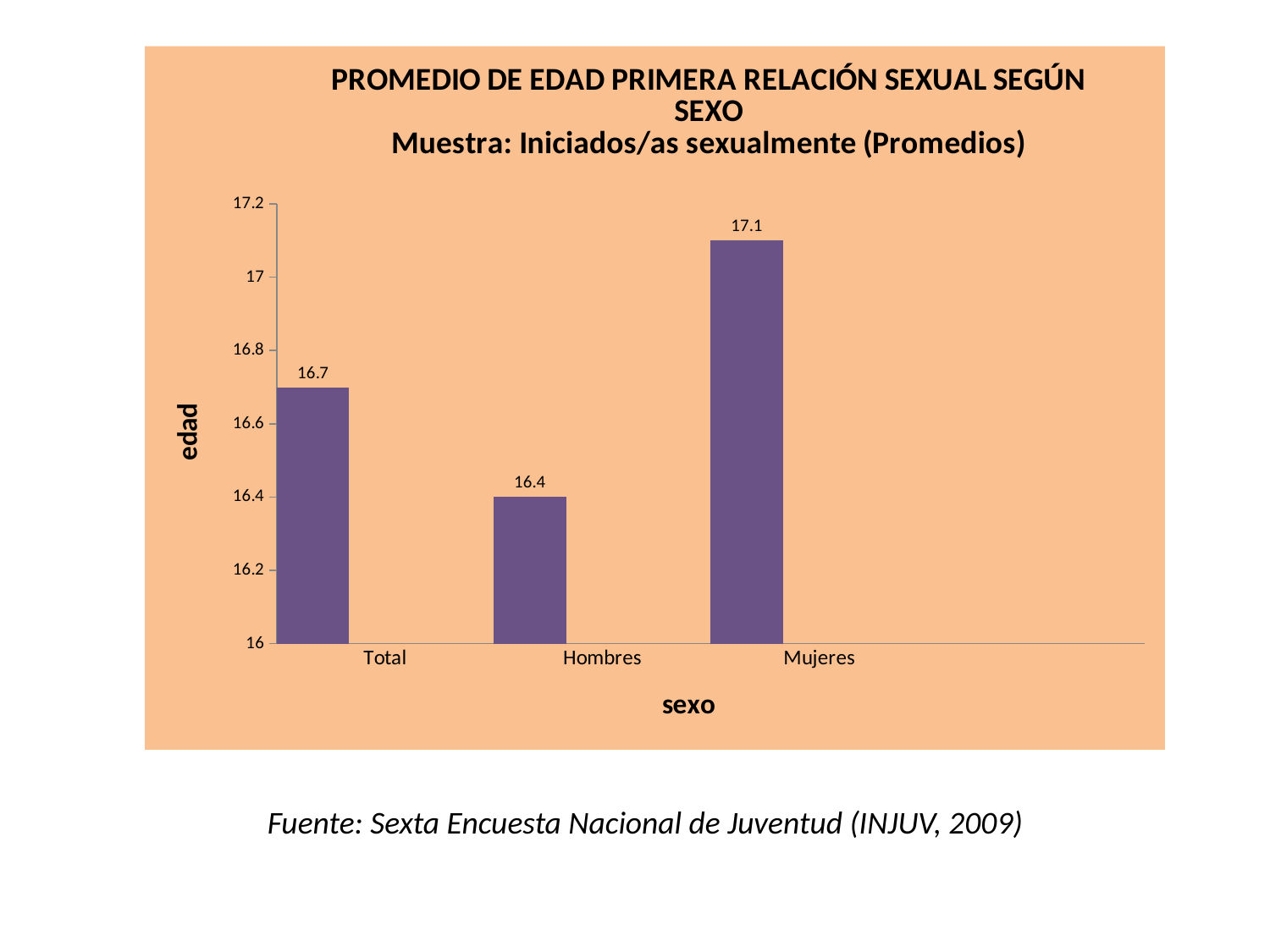
What is the value for Hombres? 16.4 Which category has the lowest value? Hombres What is the value for Total? 16.7 Which is larger, the value for Total or the value for Mujeres? Mujeres How many categories are shown on the x axis? 3 What is the label of the vertical axis? edad What is the difference between the values for Mujeres and Hombres? 0.7 Is the value for Mujeres greater or less than 17? greater Which category has the highest value? Mujeres What kind of chart is shown on the slide? bar chart What is the value for Mujeres? 17.1 What is the difference between the values for Total and Hombres? 0.3